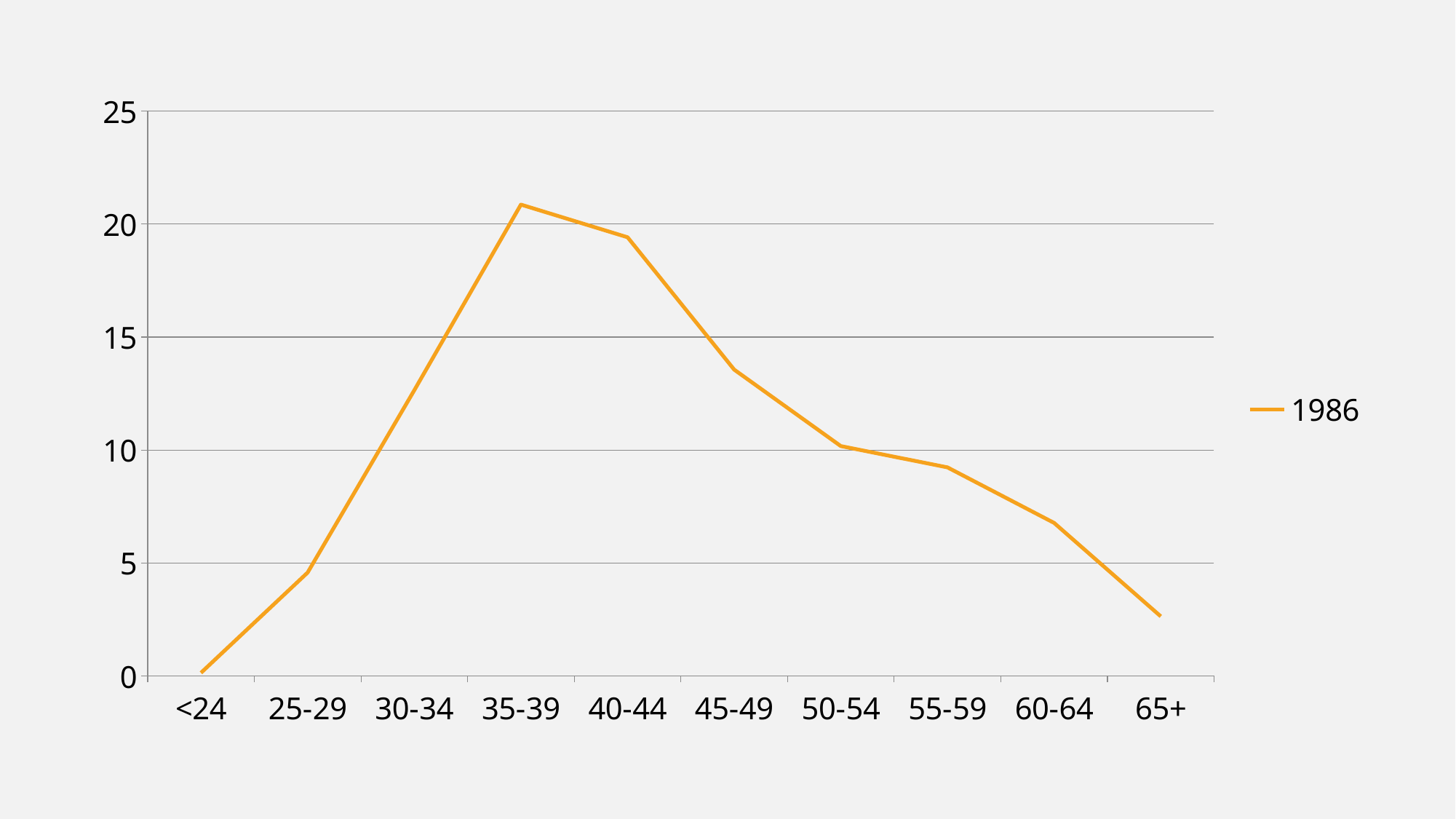
Which age category has the lowest value for 1986? <24 Is the value for 25-29 greater or less than 5? less Which has the larger value, 45-49 or 60-64? 45-49 Which age category has the highest value for 1986? 35-39 Is the value for 35-39 greater or less than 20? greater Is the value for 60-64 greater or less than 5? greater What kind of chart is shown on the slide? line chart How many age categories are plotted along the x axis? 10 Do the values rise or fall along the x axis from 35-39 to 65+? fall What is the name of the series shown in the legend? 1986 How many series does the legend list? 1